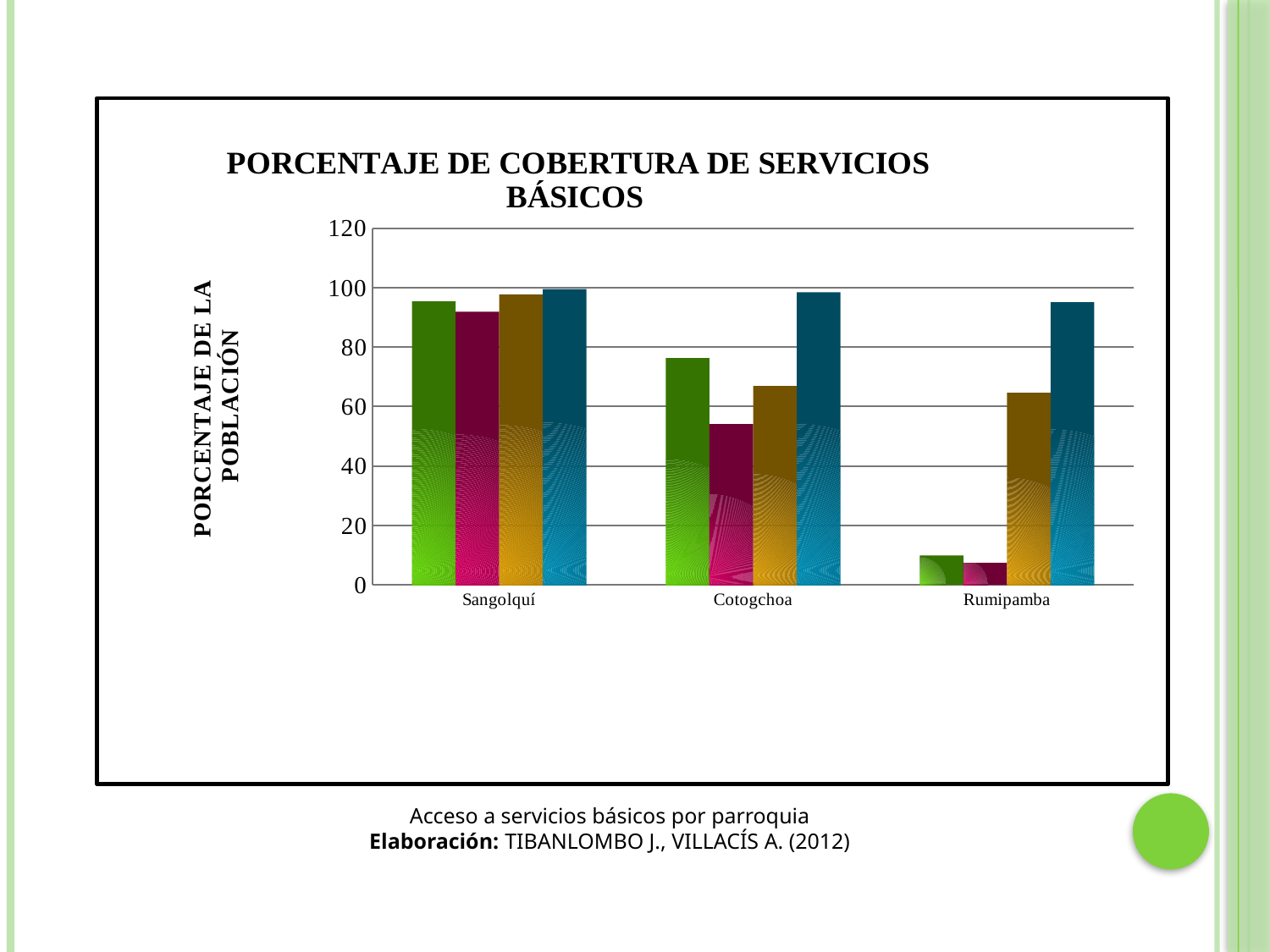
Is the value of the gold bar for Rumipamba greater or less than 40? greater What is the label of the vertical axis? PORCENTAJE DE LA POBLACIÓN How many parroquias (categories) are shown on the x axis? 3 Is the value of the magenta bar for Rumipamba greater or less than 20? less What kind of chart is shown on the slide? bar chart What is the title of the chart? PORCENTAJE DE COBERTURA DE SERVICIOS BÁSICOS How many bars are plotted for each parroquia? 4 Is the value of the blue bar for Cotogchoa greater or less than 80? greater Which parroquia has the shortest magenta bar? Rumipamba Which parroquia has the tallest green bar? Sangolquí Which is larger, the green bar for Sangolquí or the green bar for Cotogchoa? Sangolquí